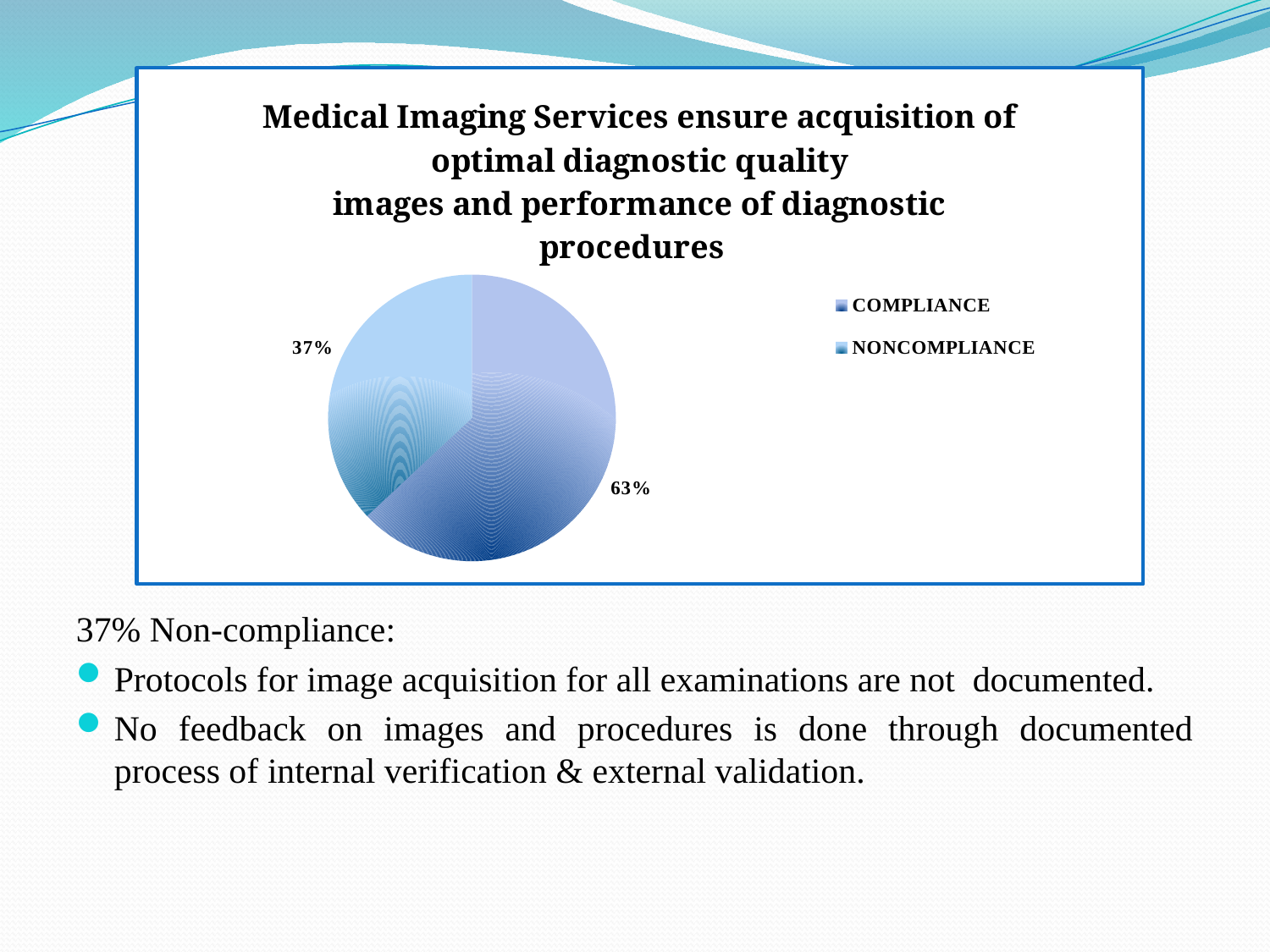
Which is larger, the COMPLIANCE slice or the NONCOMPLIANCE slice? COMPLIANCE What kind of chart is shown on the slide? pie chart How many entries does the legend list? 2 Which slice of the pie is the largest? COMPLIANCE Which slice of the pie is the smallest? NONCOMPLIANCE What percentage of the pie is labelled COMPLIANCE? 63% How many slices does the pie chart have? 2 Which legend entry is listed first? COMPLIANCE What percentage of the pie is labelled NONCOMPLIANCE? 37% What is the difference in percentage points between the COMPLIANCE and NONCOMPLIANCE slices? 26 What is the first line of the chart title? Medical Imaging Services ensure acquisition of What share of the pie does the NONCOMPLIANCE slice represent? 37%